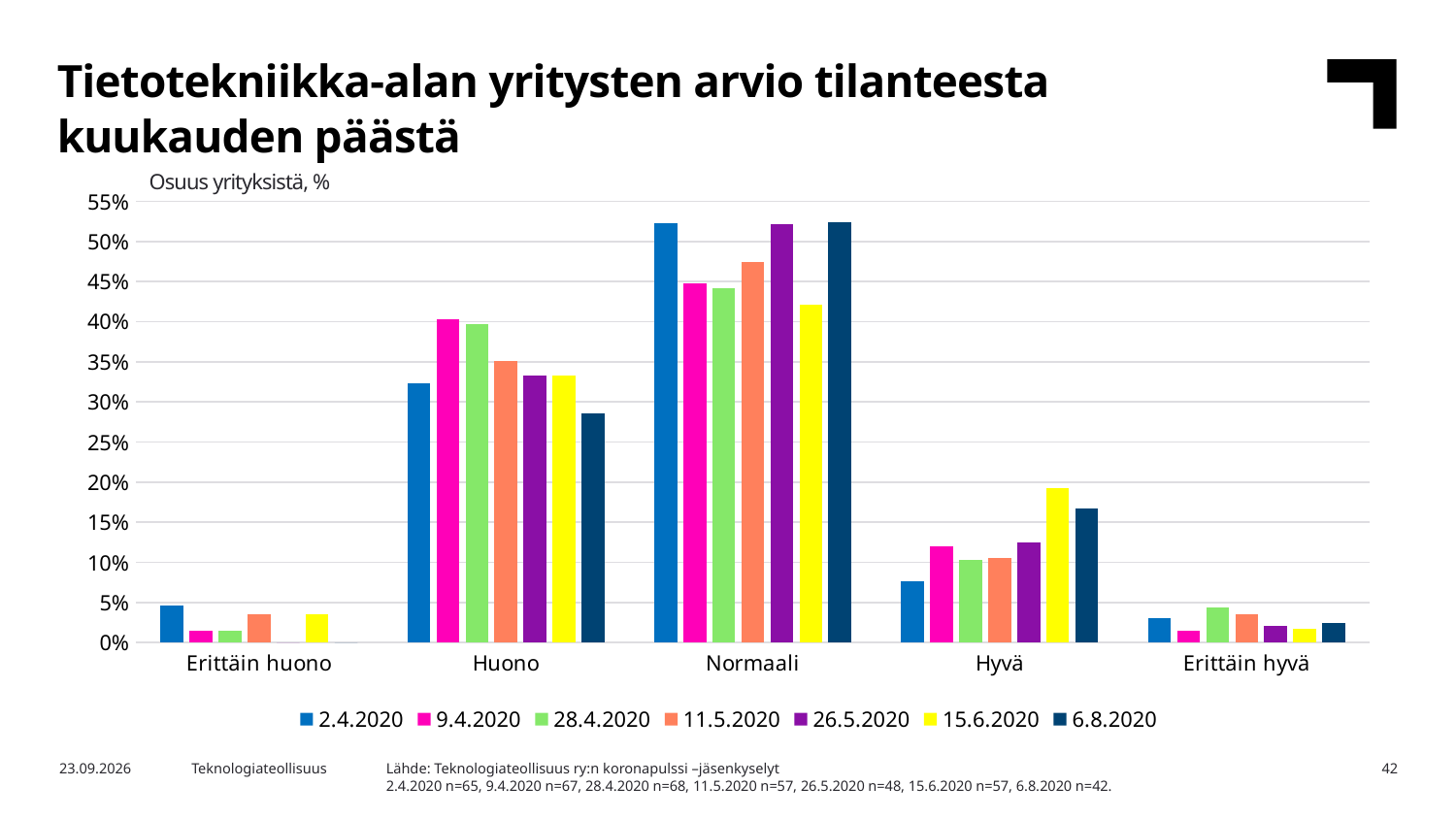
Is the value for Hyvä in the 15.6.2020 series greater or less than 15%? greater For the category Huono, which series has the lowest value? 6.8.2020 How many series does the legend list? 7 Is the value for Huono in the 6.8.2020 series greater or less than 30%? less For the category Huono, which is larger: the 2.4.2020 value or the 6.8.2020 value? 2.4.2020 What is the label shown above the y axis of the chart? Osuus yrityksistä, % Is the value for Huono in the 9.4.2020 series greater or less than 35%? greater For the category Hyvä, which is larger: the 15.6.2020 value or the 6.8.2020 value? 15.6.2020 Which category has the highest value in the 6.8.2020 series? Normaali What kind of chart is shown on the slide? bar chart How many categories are shown on the x axis? 5